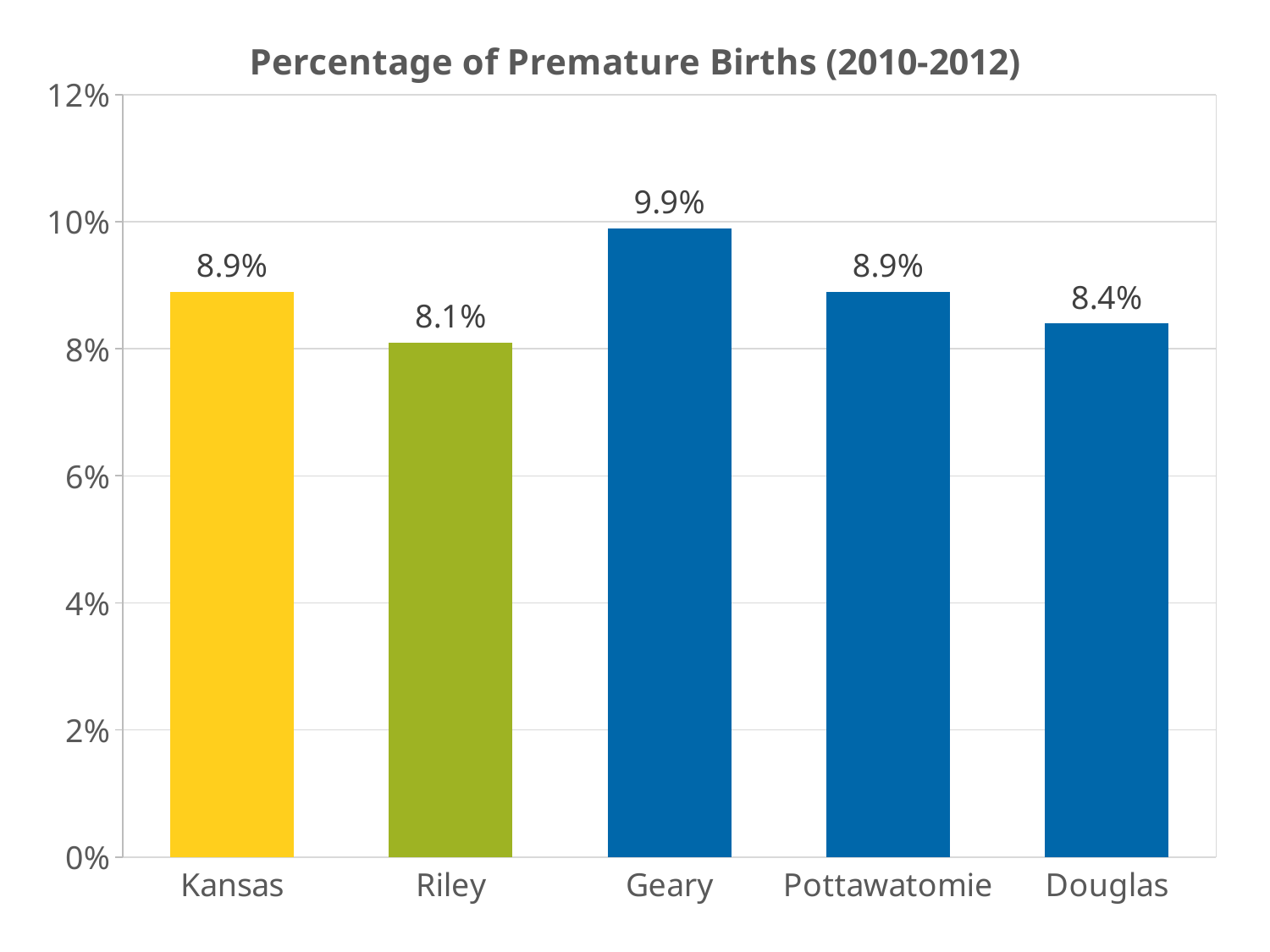
How many categories are shown on the x axis? 5 What is the percentage of premature births for Douglas? 8.4% Which is larger, the value for Pottawatomie or the value for Douglas? Pottawatomie What is the percentage of premature births for Geary? 9.9% Is the value for Geary greater or less than 8%? greater What is the difference between the percentage for Geary and the percentage for Riley? 1.8% Which category has the lowest percentage of premature births? Riley What is the percentage of premature births for Riley? 8.1% What is the title of the chart? Percentage of Premature Births (2010-2012) What is the percentage of premature births for Kansas? 8.9% What kind of chart is shown on the slide? Bar chart Which category has the highest percentage of premature births? Geary